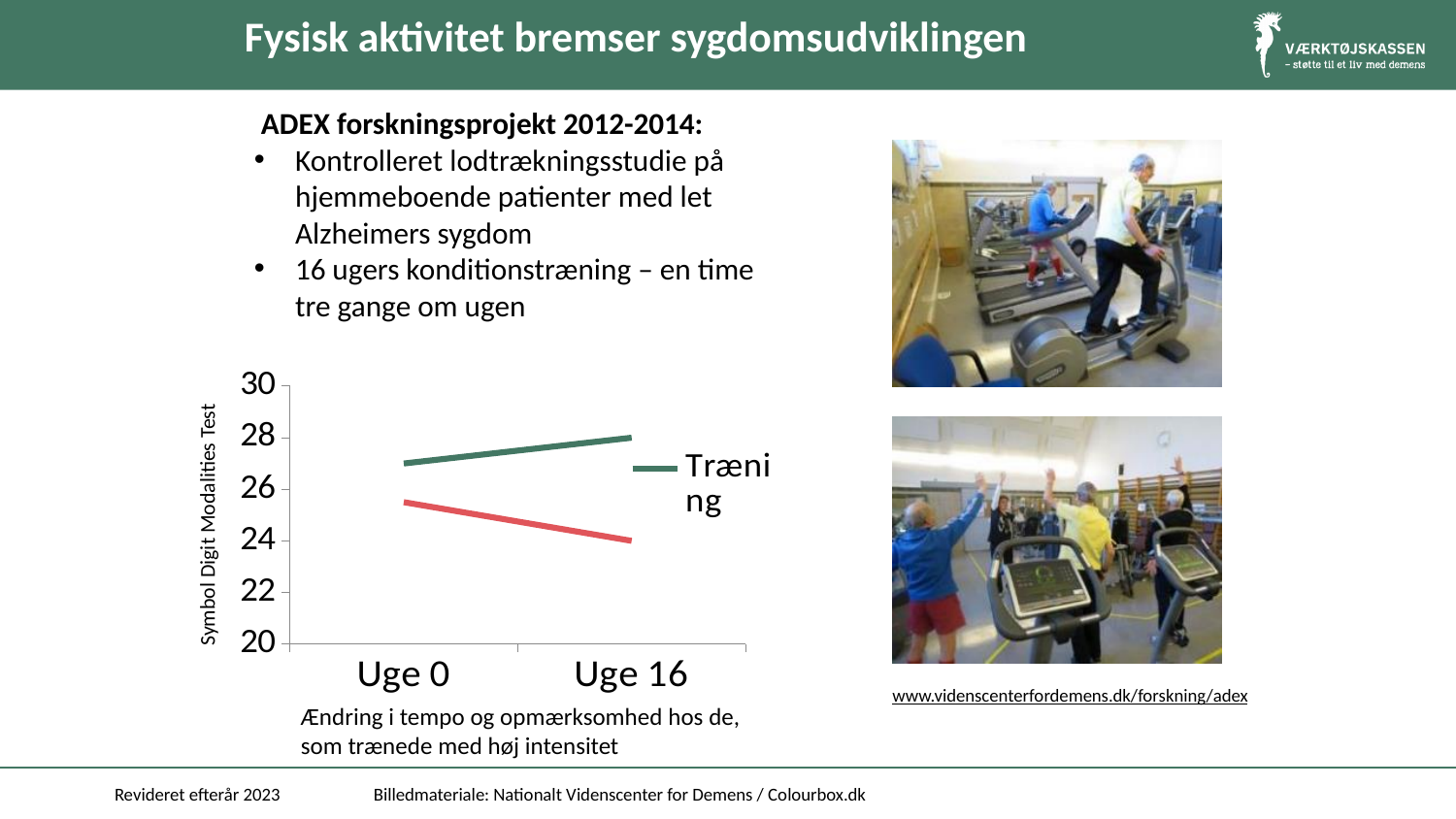
At Uge 16, which line is higher, the Træning line or the red line? Træning Does the Træning line rise or fall from Uge 0 to Uge 16? rise How many points are on the x axis of the chart? 2 What is the title of the y axis on the chart? Symbol Digit Modalities Test Is the value of the red line at Uge 16 greater or less than 26? less Is the value of the red line at Uge 0 greater or less than 24? greater Is the value for Træning at Uge 16 greater or less than 26? greater Does the red line rise or fall from Uge 0 to Uge 16? fall How many lines are plotted on the chart? 2 What are the two x-axis labels on the chart? Uge 0 and Uge 16 What kind of chart is shown on the slide? line chart